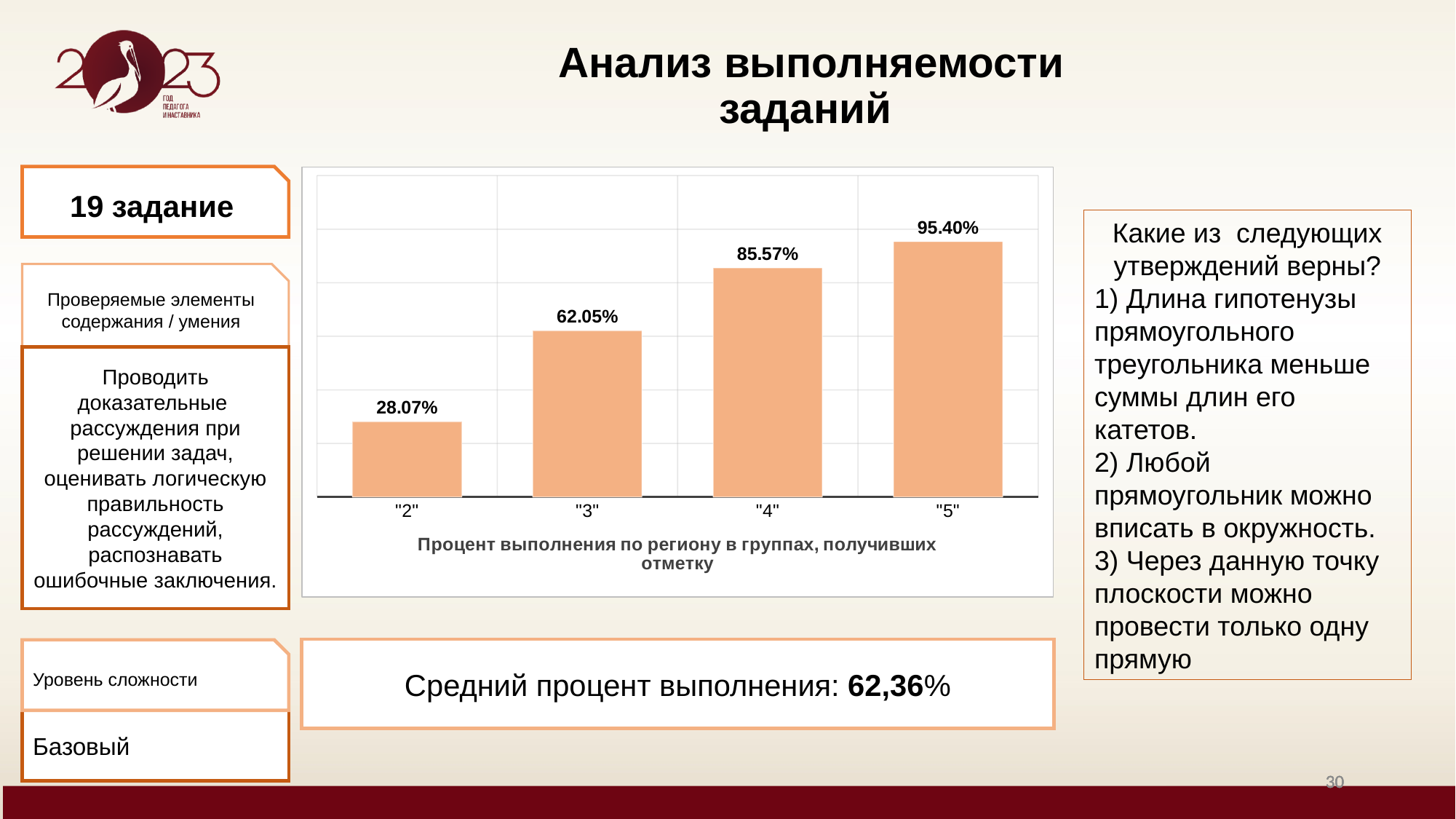
What is the difference in completion percentage between the "5" group and the "2" group? 67.33% What is the completion percentage for the group that received mark "2"? 28.07% What is the completion percentage for the group that received mark "3"? 62.05% Do the completion percentages rise or fall as the mark increases from "2" to "5"? Rise Which group has a higher completion percentage, "3" or "4"? "4" Which mark group has the lowest completion percentage? "2" How many mark groups are shown in the chart? 4 Which mark group has the highest completion percentage? "5" What is the difference in completion percentage between the "4" group and the "3" group? 23.52% What is the completion percentage for the group that received mark "5"? 95.40% What type of chart is shown on the slide? Bar chart What is the completion percentage for the group that received mark "4"? 85.57%